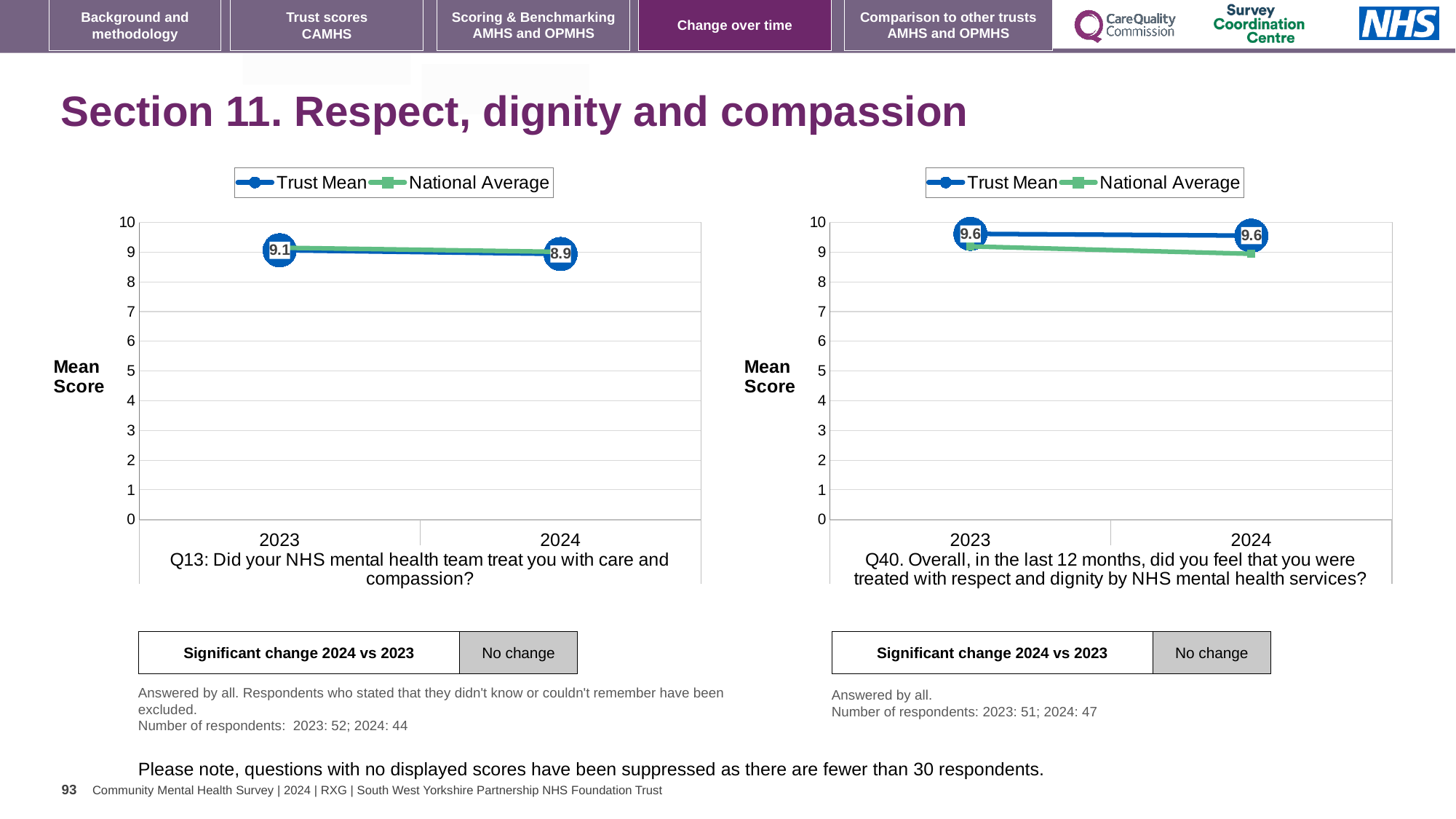
In the Q13 chart on the left, by how much did the Trust Mean change from 2023 to 2024? 0.2 In the Q40 chart on the right, is the National Average for 2024 greater or less than 8? greater In the Q40 chart on the right, does the Trust Mean rise, fall or stay the same from 2023 to 2024? stays the same How many years are shown on the x axis of the Q13 chart on the left? 2 In the Q13 chart on the left, what is the Trust Mean score for 2024? 8.9 How many series does the legend of the Q40 chart on the right list? 2 In the Q40 chart on the right, what is the Trust Mean score for 2024? 9.6 In the Q13 chart on the left, does the Trust Mean rise or fall from 2023 to 2024? fall In the Q40 chart on the right, which is larger in 2024, the Trust Mean or the National Average? Trust Mean In the Q13 chart on the left, which colour is used for the National Average line? green In the Q13 chart on the left, what is the Trust Mean score for 2023? 9.1 What kind of chart is the Q13 chart on the left? line chart